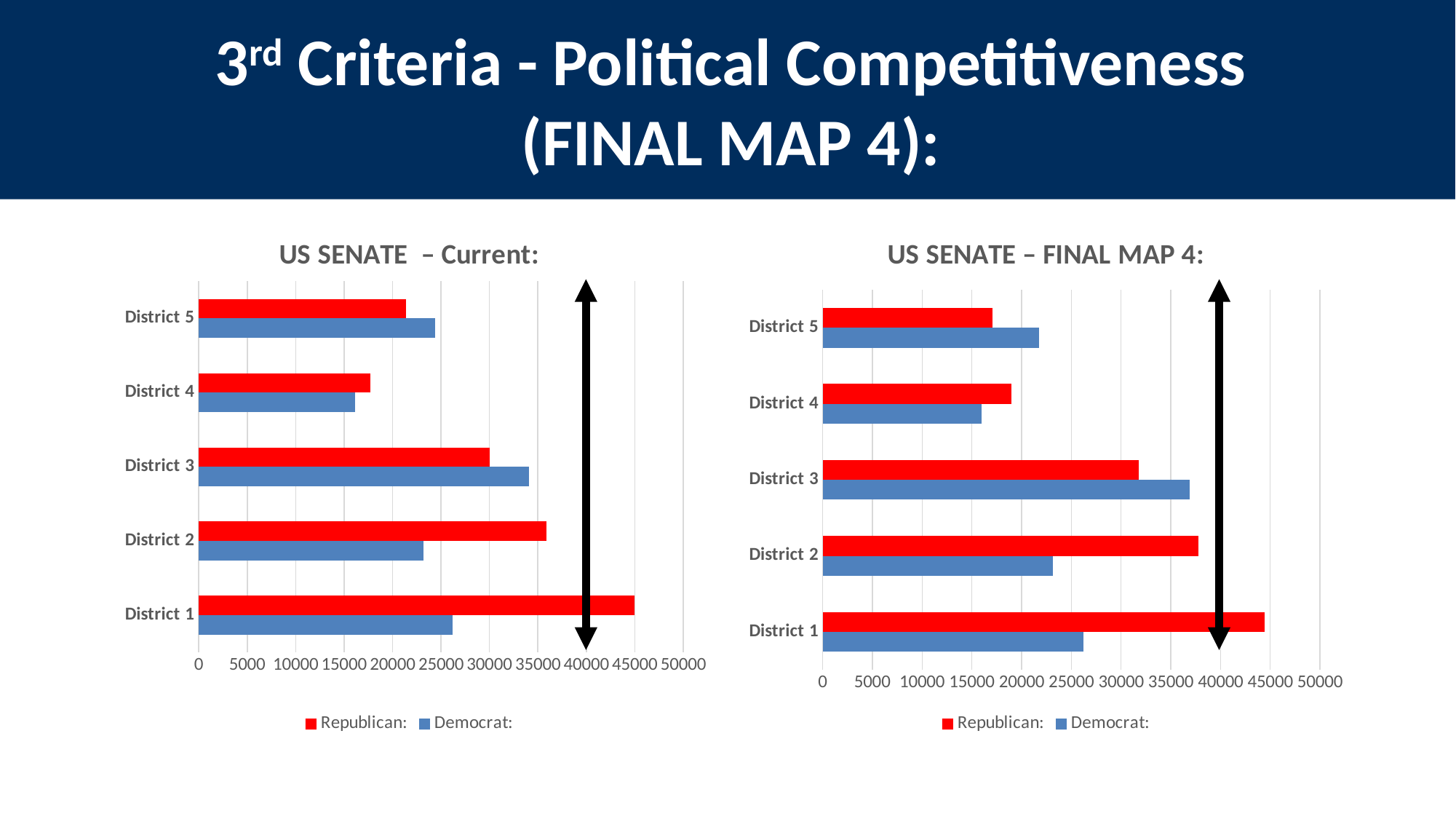
In the "US SENATE – FINAL MAP 4" chart, which district has the lowest Democrat value? District 4 In the "US SENATE – Current" chart, is the Republican value for District 1 greater or less than 40000? greater In the "US SENATE – Current" chart, which district has the highest Republican value? District 1 How many series does the legend of the "US SENATE – FINAL MAP 4" chart list? 2 In the "US SENATE – FINAL MAP 4" chart, is the Democrat value for District 3 greater or less than 35000? greater In the "US SENATE – FINAL MAP 4" chart, is the Democrat value for District 4 greater or less than 20000? less In the "US SENATE – Current" chart, for District 3, which is larger: Republican or Democrat? Democrat In the "US SENATE – FINAL MAP 4" chart, for District 2, which is larger: Republican or Democrat? Republican In the "US SENATE – Current" chart, what colour represents the Republican series? red How many districts are shown in the "US SENATE – Current" chart? 5 What kind of chart is the "US SENATE – Current" chart on the left? bar chart In the "US SENATE – Current" chart, which district has the lowest Republican value? District 4